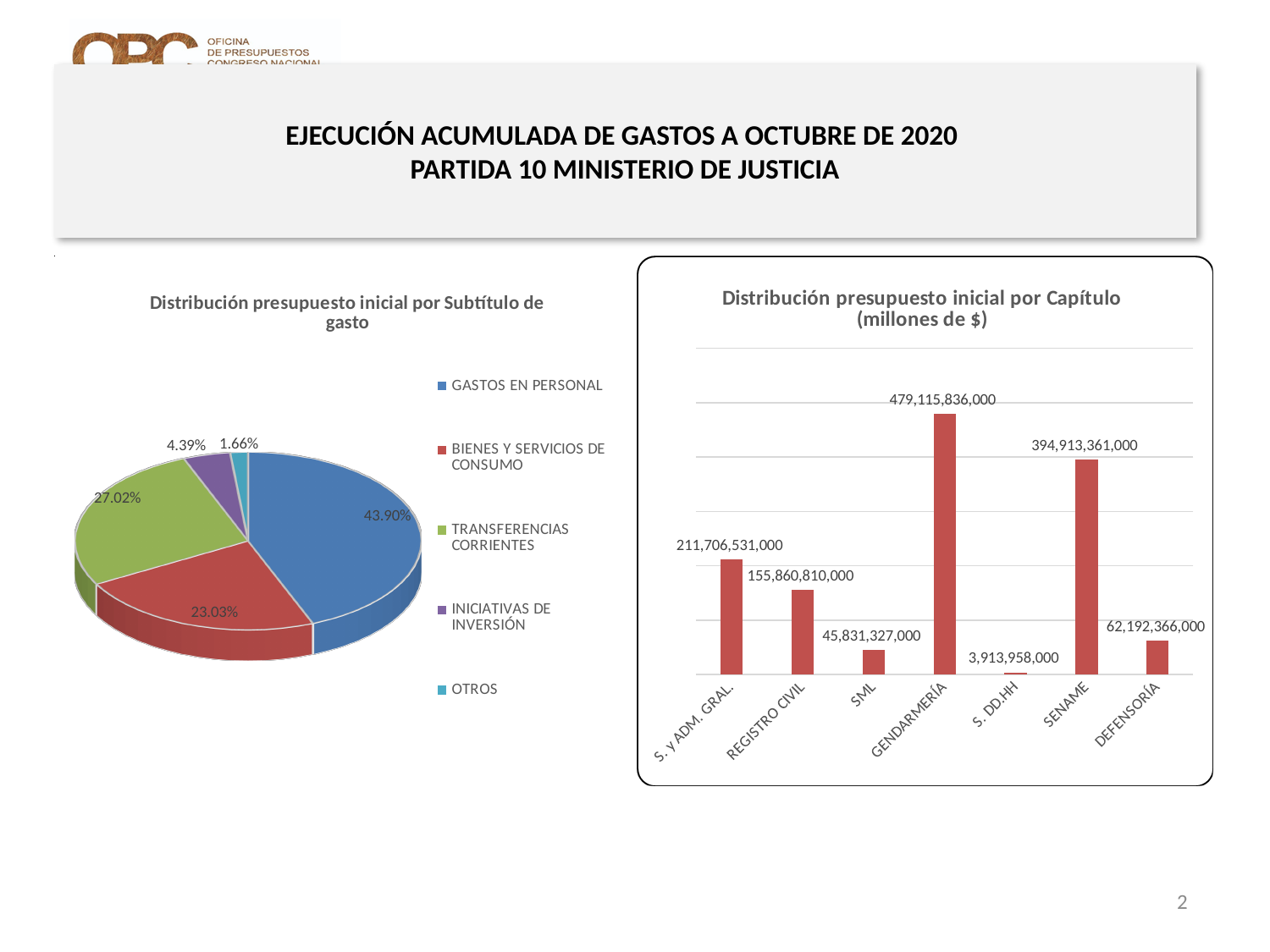
What kind of chart is 'Distribución presupuesto inicial por Capítulo (millones de $)'? Bar chart In the chart 'Distribución presupuesto inicial por Subtítulo de gasto', what share does GASTOS EN PERSONAL have? 43.90% In the chart 'Distribución presupuesto inicial por Capítulo (millones de $)', what is the value for GENDARMERÍA? 479,115,836,000 In the chart 'Distribución presupuesto inicial por Subtítulo de gasto', what share does TRANSFERENCIAS CORRIENTES have? 27.02% In the chart 'Distribución presupuesto inicial por Capítulo (millones de $)', what is the value for REGISTRO CIVIL? 155,860,810,000 In the chart 'Distribución presupuesto inicial por Capítulo (millones de $)', what is the difference between GENDARMERÍA and SENAME? 84,202,475,000 In the chart 'Distribución presupuesto inicial por Capítulo (millones de $)', which category has the highest value? GENDARMERÍA What kind of chart is 'Distribución presupuesto inicial por Subtítulo de gasto'? Pie chart In the chart 'Distribución presupuesto inicial por Capítulo (millones de $)', which is larger, SML or DEFENSORÍA? DEFENSORÍA In the chart 'Distribución presupuesto inicial por Subtítulo de gasto', which category has the smallest share? OTROS In the chart 'Distribución presupuesto inicial por Subtítulo de gasto', how many categories does the legend list? 5 In the chart 'Distribución presupuesto inicial por Capítulo (millones de $)', which category has the lowest value? S. DD.HH